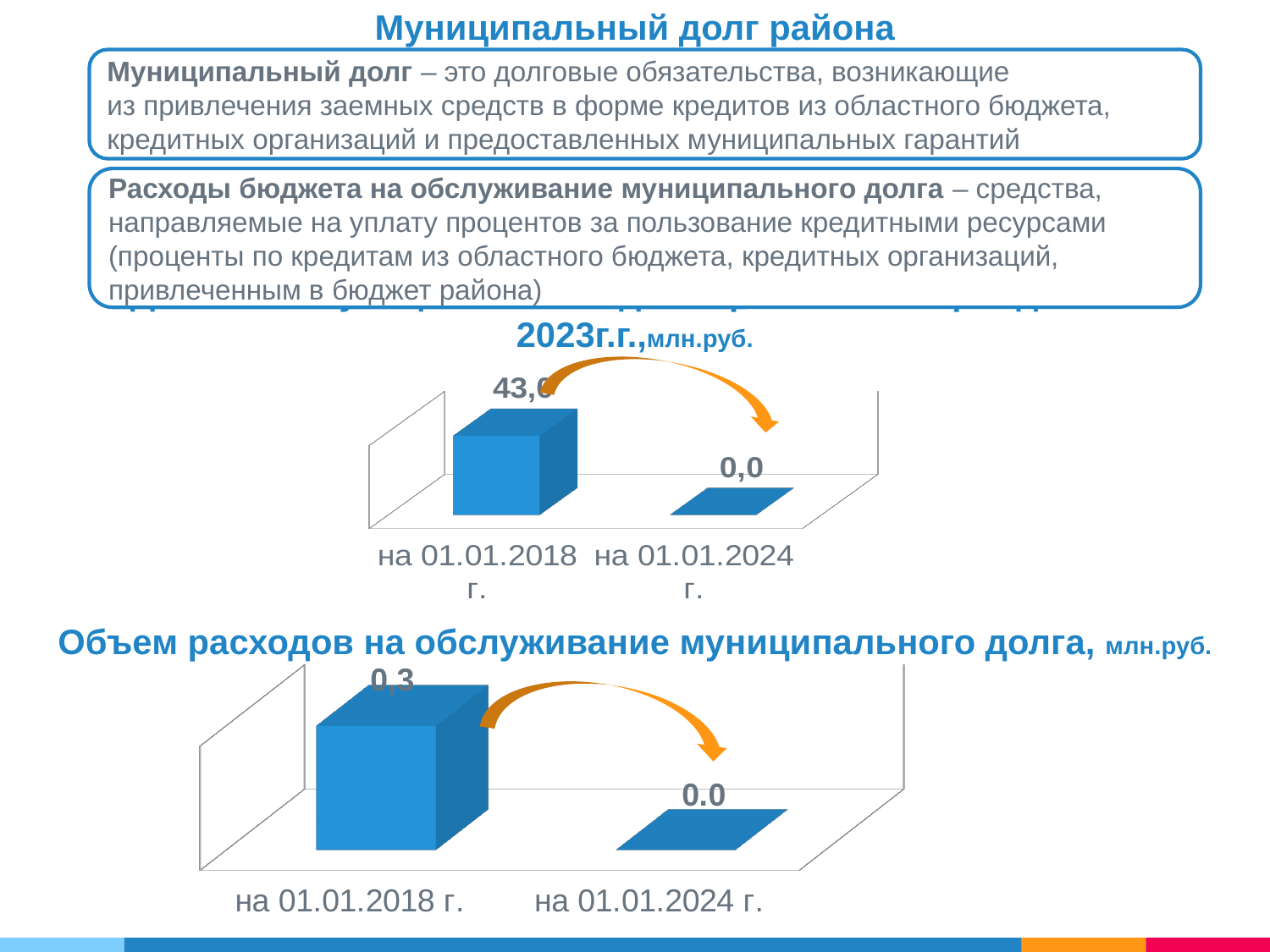
What kind of chart is the upper chart? bar chart In the upper chart, which category has the higher value, на 01.01.2018 г. or на 01.01.2024 г.? на 01.01.2018 г. What unit is stated in the title of the chart 'Объем расходов на обслуживание муниципального долга'? млн.руб. In the chart titled 'Объем расходов на обслуживание муниципального долга', what is the value for на 01.01.2018 г.? 0,3 In the upper chart, do the values rise or fall from на 01.01.2018 г. to на 01.01.2024 г.? fall In the upper chart, which category has the lowest value? на 01.01.2024 г. How many categories are shown in the chart titled 'Объем расходов на обслуживание муниципального долга'? 2 How many categories are shown in the upper chart? 2 What kind of chart is the chart titled 'Объем расходов на обслуживание муниципального долга'? bar chart In the chart titled 'Объем расходов на обслуживание муниципального долга', which category has the lowest value? на 01.01.2024 г. In the upper chart, what is the value for на 01.01.2024 г.? 0,0 In the chart titled 'Объем расходов на обслуживание муниципального долга', which category has the highest value? на 01.01.2018 г.